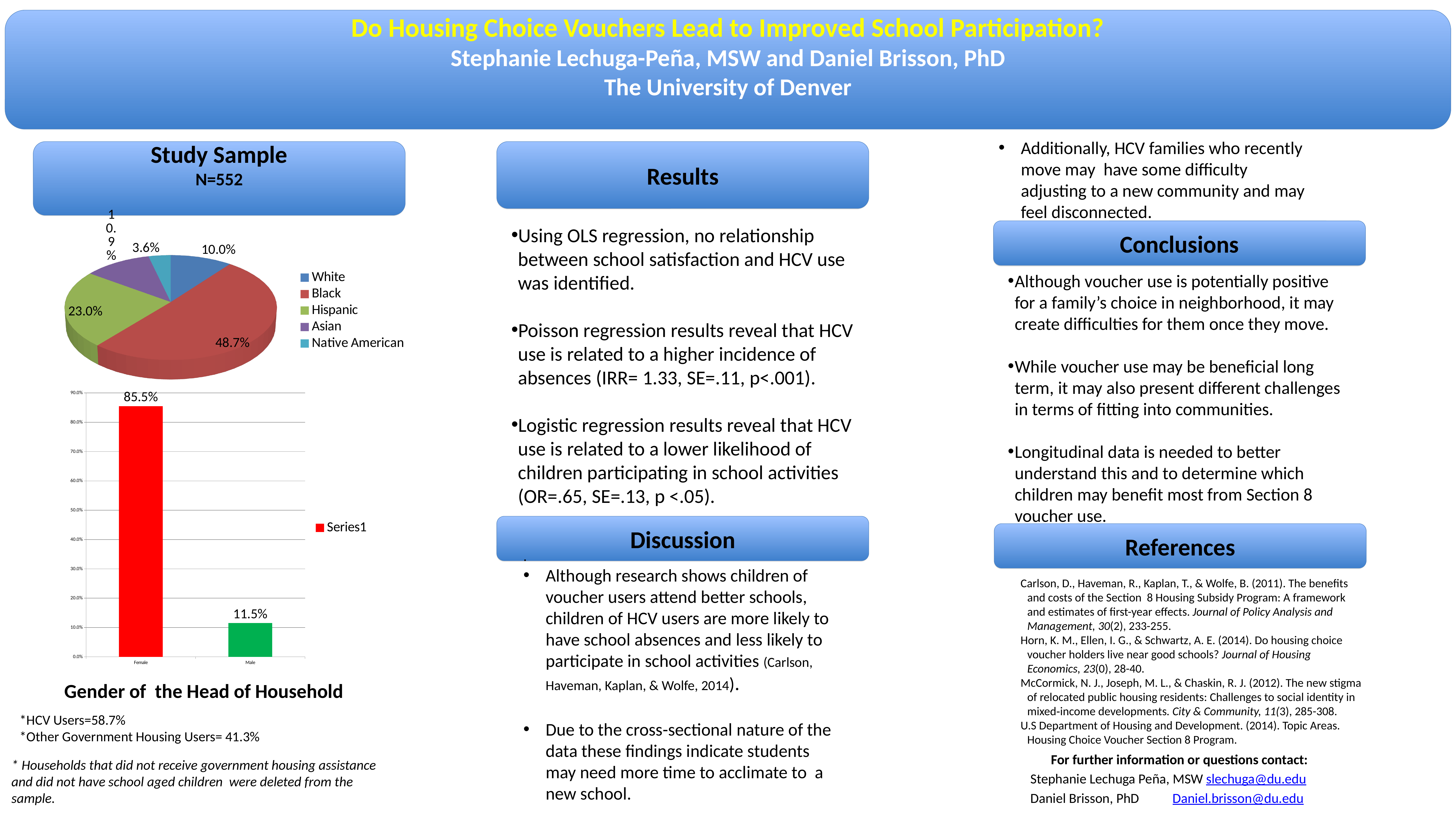
In the pie chart in the Study Sample section, what is the difference between the Black and Hispanic shares? 25.7% In the 'Gender of the Head of Household' chart, what is the legend entry shown? Series1 In the pie chart in the Study Sample section, how many categories does the legend list? 5 In the pie chart in the Study Sample section, what share is labelled for Black? 48.7% In the 'Gender of the Head of Household' chart, what is the difference between the Female and Male values? 74.0% In the pie chart in the Study Sample section, which category has the largest slice? Black In the 'Gender of the Head of Household' chart, what is the value for Female? 85.5% In the 'Gender of the Head of Household' chart, what is the value for Male? 11.5% In the pie chart in the Study Sample section, which category has the smallest slice? Native American What kind of chart is the 'Gender of the Head of Household' chart? Bar chart In the pie chart in the Study Sample section, what share is labelled for Hispanic? 23.0% In the pie chart in the Study Sample section, what share is labelled for Native American? 3.6%